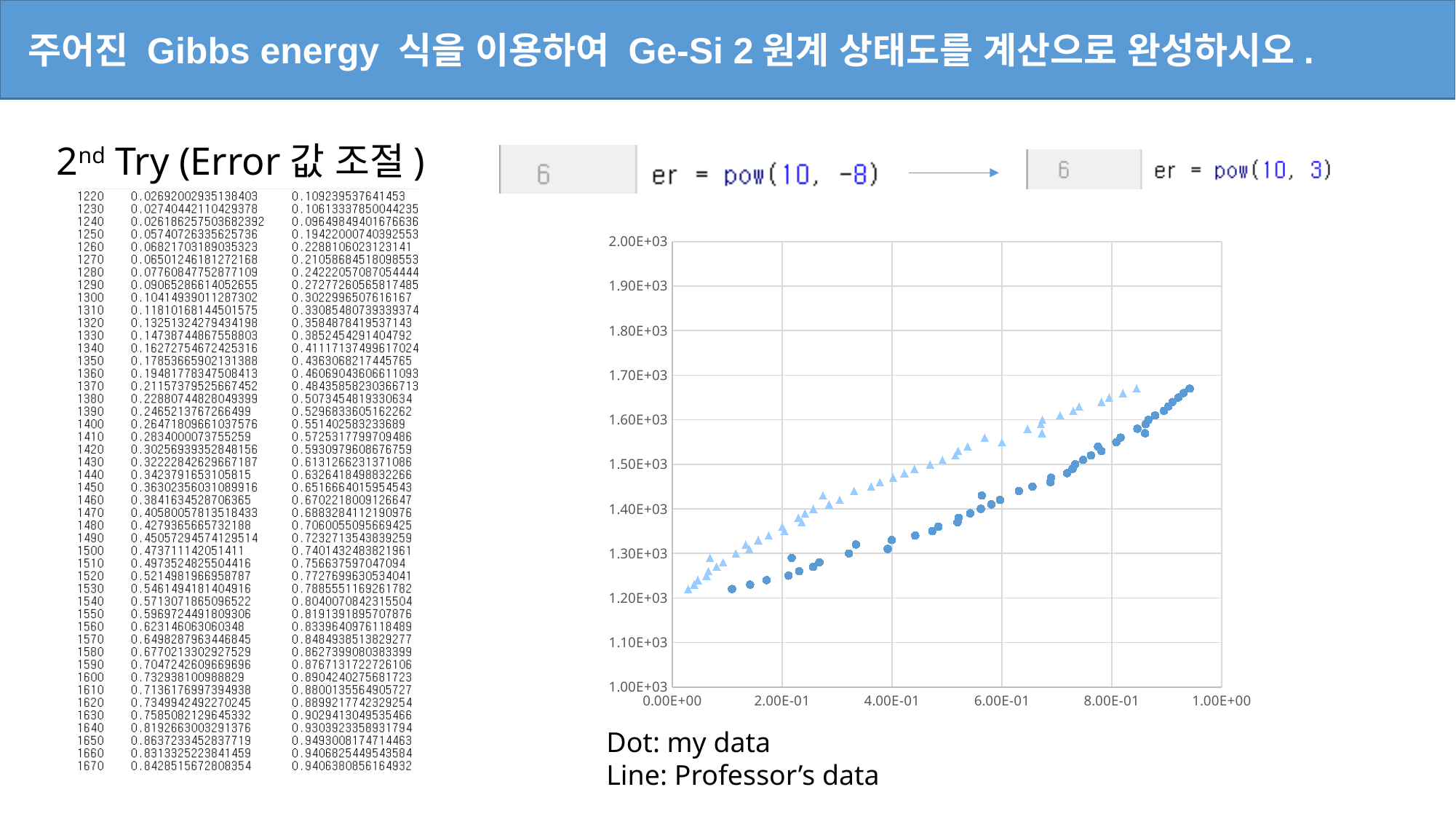
What kind of chart is shown on the slide? scatter chart What is the maximum value shown on the chart's y axis? 2.00E+03 Is the highest plotted value in the chart greater or less than 1.70E+03? less Do the plotted values rise or fall as the x-axis value increases? rise Is the value of the circle series at x = 6.00E-01 greater or less than 1.50E+03? less Is the value of the circle series at x = 2.00E-01 greater or less than 1.40E+03? less According to the text below the chart, what do the dots represent? my data At x = 4.00E-01, which series has the higher value, the triangle series or the circle series? triangle series